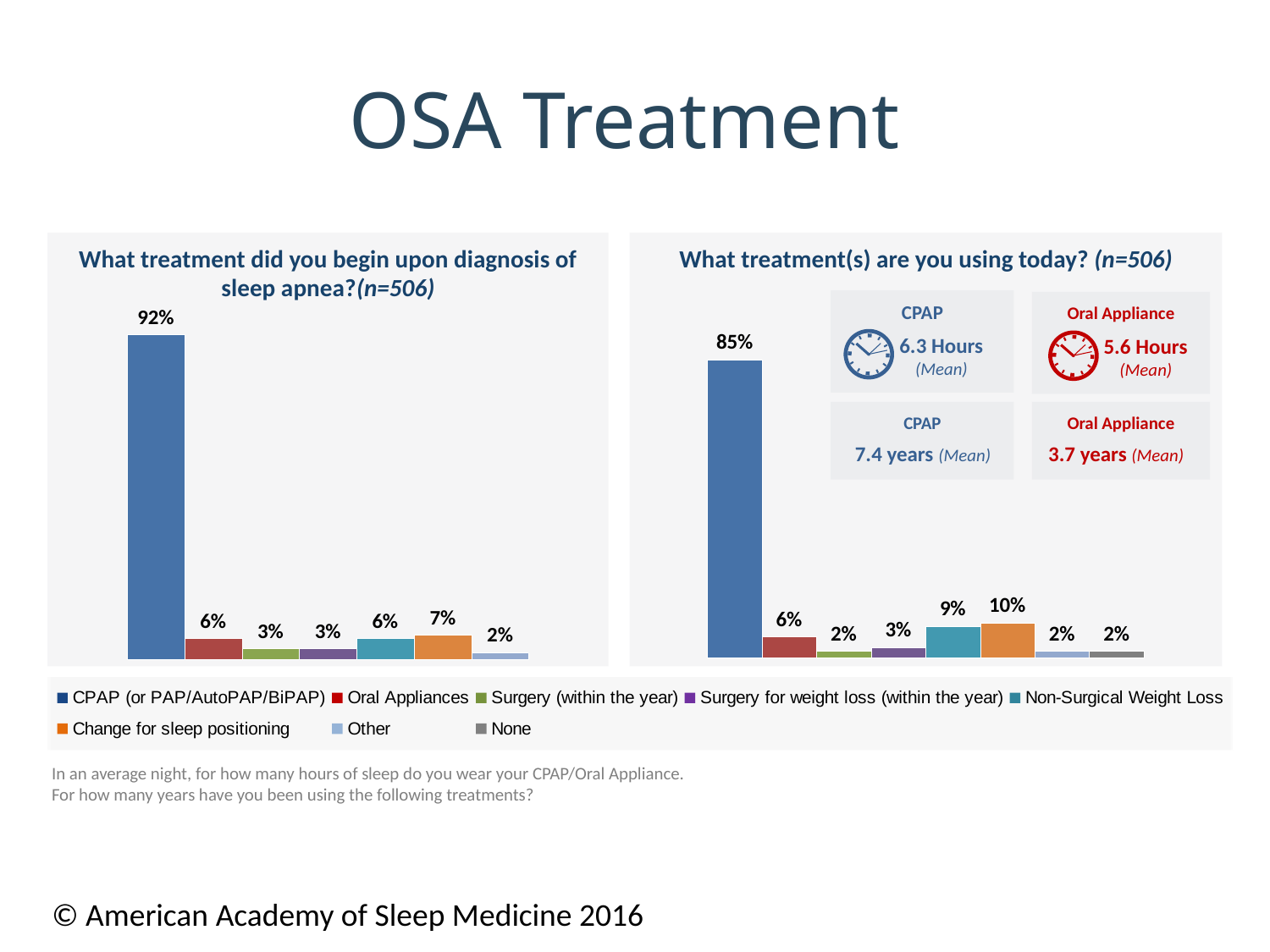
In the chart 'What treatment(s) are you using today?', which treatment has the highest percentage? CPAP (or PAP/AutoPAP/BiPAP) In the chart 'What treatment(s) are you using today?', what is the difference between Change for sleep positioning and Non-Surgical Weight Loss? 1% In the chart 'What treatment(s) are you using today?', what percentage are using CPAP (or PAP/AutoPAP/BiPAP)? 85% How many bars are plotted in the chart 'What treatment(s) are you using today?'? 8 In the chart 'What treatment did you begin upon diagnosis of sleep apnea?', what percentage began CPAP (or PAP/AutoPAP/BiPAP)? 92% In the chart 'What treatment(s) are you using today?', which is larger: Non-Surgical Weight Loss or Oral Appliances? Non-Surgical Weight Loss In the chart 'What treatment did you begin upon diagnosis of sleep apnea?', which treatment has the highest percentage? CPAP (or PAP/AutoPAP/BiPAP) In the chart 'What treatment did you begin upon diagnosis of sleep apnea?', which treatment has the lowest percentage? Other What type of chart is used for 'What treatment did you begin upon diagnosis of sleep apnea?'? Bar chart In the chart 'What treatment(s) are you using today?', what percentage are using Change for sleep positioning? 10% What is the difference between the CPAP percentage in the left chart (treatment begun upon diagnosis) and the CPAP percentage in the right chart (treatment used today)? 7% How many entries does the shared legend list? 8